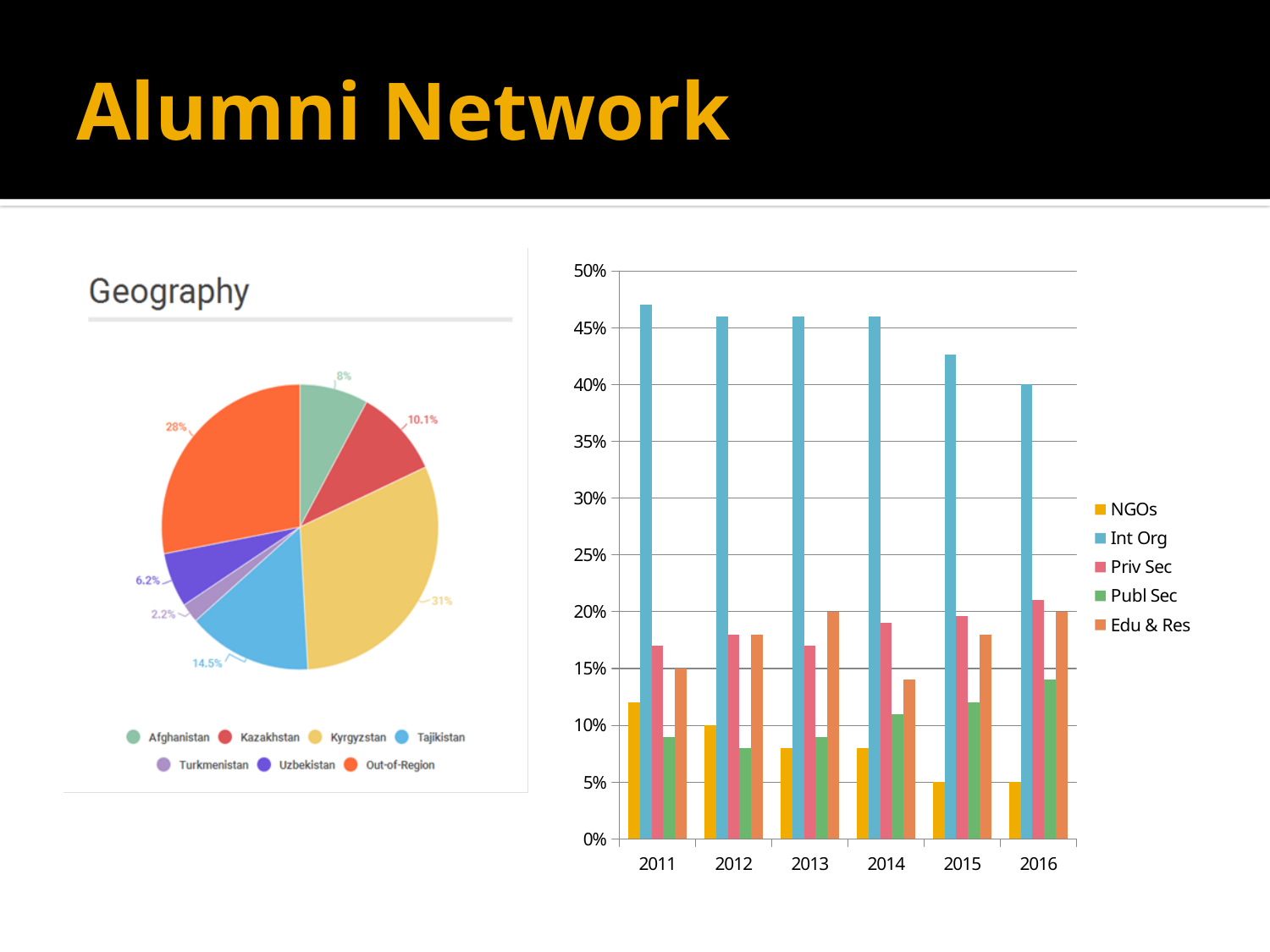
In the bar chart on the right, do the NGOs values rise or fall from 2011 to 2016? fall How many series does the legend of the bar chart on the right list? 5 In the bar chart on the right, what is the value for Int Org in 2016? 40% What kind of chart is the chart on the right of the slide? Bar chart In the bar chart on the right, which is larger in 2016: Priv Sec or Publ Sec? Priv Sec How many categories does the Geography pie chart show? 7 In the Geography pie chart, what share does Out-of-Region have? 28% In the Geography pie chart, which category has the smallest slice? Turkmenistan In the Geography pie chart, how much larger is Kyrgyzstan's share than Out-of-Region's share? 3% In the Geography pie chart, what share does Kyrgyzstan have? 31% In the bar chart on the right, is the value for Int Org in 2011 greater or less than 45%? greater In the Geography pie chart, which category has the largest slice? Kyrgyzstan